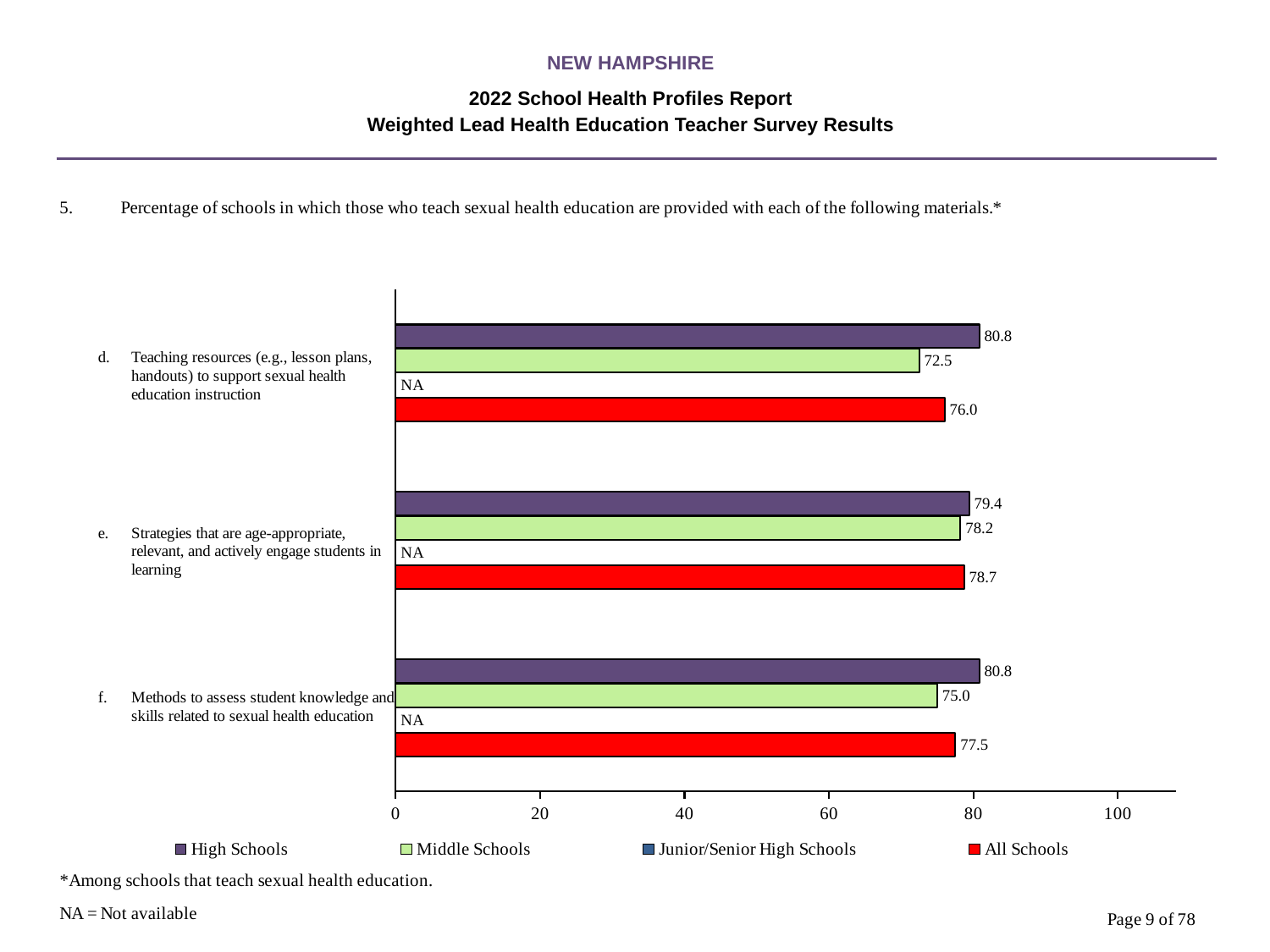
What value is shown for Junior/Senior High Schools for item d? NA What is the High Schools value for item d, teaching resources to support sexual health education instruction? 80.8 What is the difference between the High Schools and Middle Schools values for item f? 5.8 What kind of chart is shown on the slide? Bar chart How many series does the legend list? 4 Which item has the lowest Middle Schools value? d. Teaching resources (e.g., lesson plans, handouts) to support sexual health education instruction What colour represents All Schools in the legend? Red Which item has the highest All Schools value? e. Strategies that are age-appropriate, relevant, and actively engage students in learning What is the Middle Schools value for item e, strategies that are age-appropriate, relevant, and actively engage students in learning? 78.2 What is the difference between the High Schools and Middle Schools values for item d? 8.3 For item e, which is larger: the High Schools value or the All Schools value? High Schools What is the All Schools value for item f, methods to assess student knowledge and skills related to sexual health education? 77.5